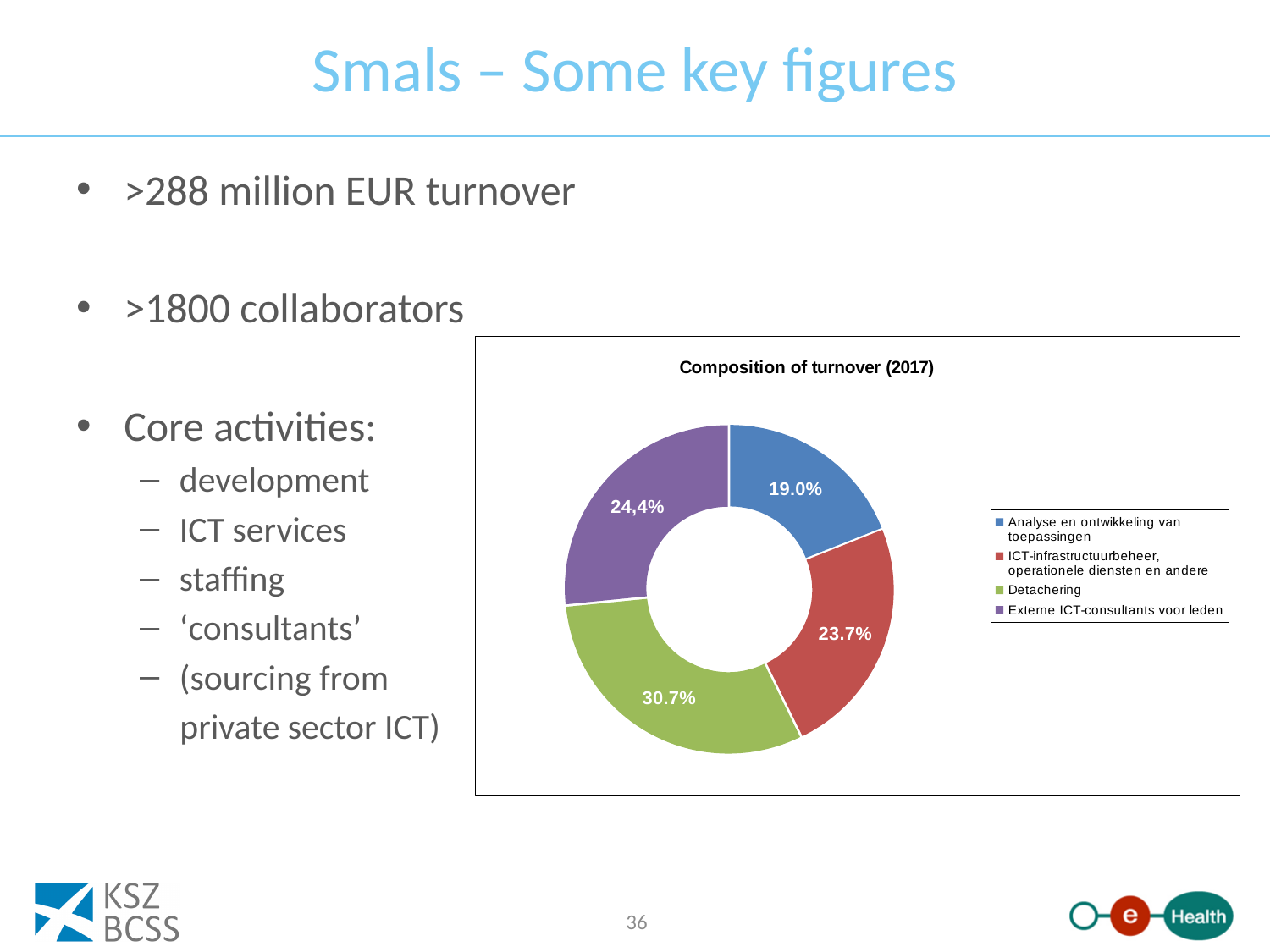
How many entries does the legend of the Composition of turnover (2017) chart list? 4 What share of turnover does Detachering represent in the Composition of turnover (2017) chart? 30.7% What is the title of the chart on the slide? Composition of turnover (2017) How many slices does the Composition of turnover (2017) chart have? 4 What kind of chart is shown on the slide? doughnut chart Which category has the largest share of turnover in the chart? Detachering Which category has the smallest share of turnover in the chart? Analyse en ontwikkeling van toepassingen What is the difference in percentage points between the Detachering share and the 'Analyse en ontwikkeling van toepassingen' share? 11.7 What share of turnover does 'ICT-infrastructuurbeheer, operationele diensten en andere' represent? 23.7% Which colour represents Detachering in the chart? green What share of turnover does 'Externe ICT-consultants voor leden' represent? 24,4% What share of turnover does 'Analyse en ontwikkeling van toepassingen' represent? 19.0%